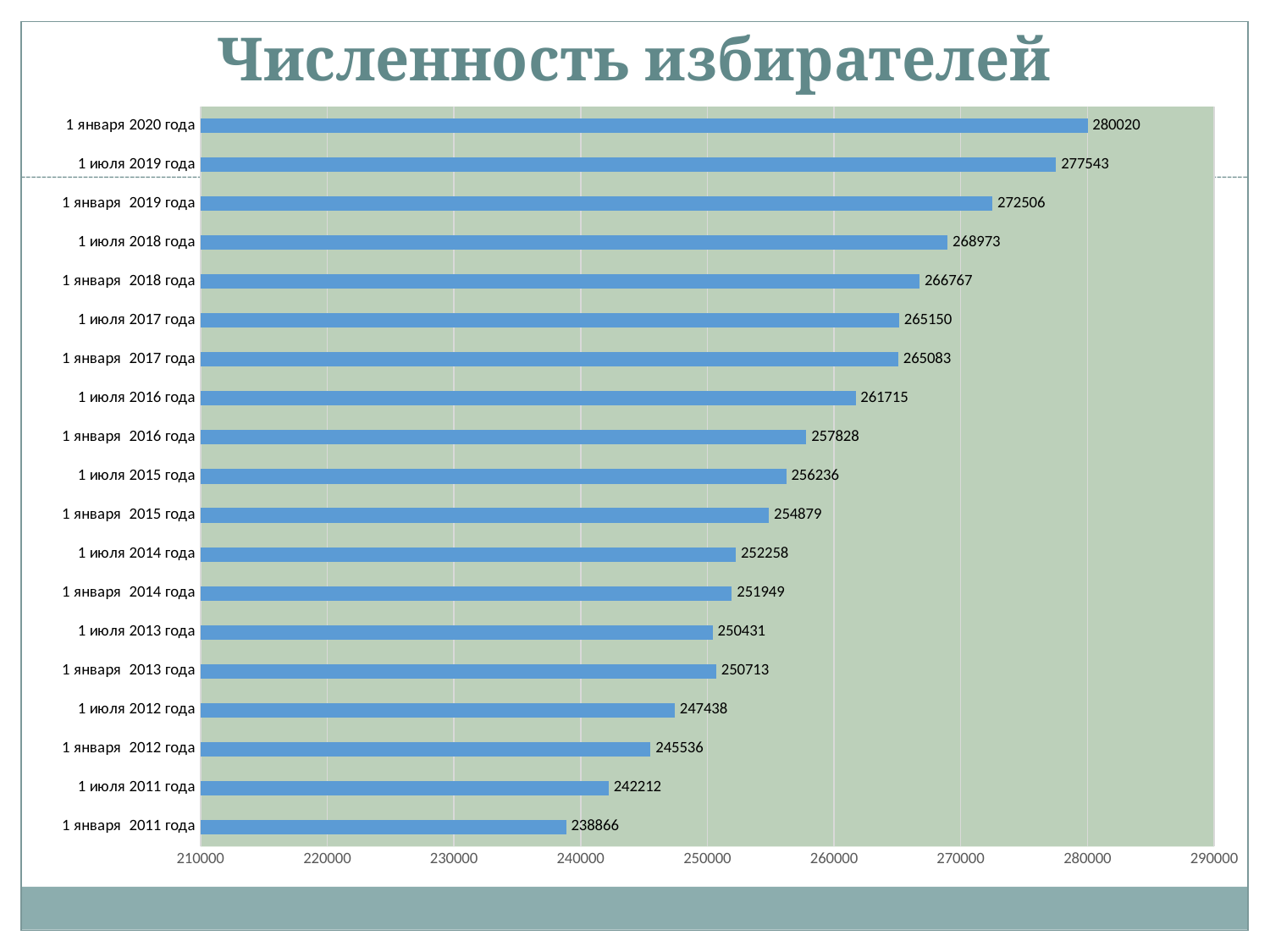
Which category has the highest value? 1 января 2020 года What is the value for 1 января 2020 года? 280020 What kind of chart is shown on the slide? bar chart Which is larger, the value for 1 июля 2018 года or the value for 1 января 2016 года? 1 июля 2018 года What is the value for 1 января 2011 года? 238866 Is the value for 1 июля 2016 года greater or less than 260000? greater How many categories are shown in the chart? 19 What is the difference between the values for 1 января 2020 года and 1 января 2011 года? 41154 Which category has the lowest value? 1 января 2011 года What is the difference between the values for 1 июля 2019 года and 1 января 2019 года? 5037 What is the value for 1 июля 2015 года? 256236 What is the title of the chart? Численность избирателей